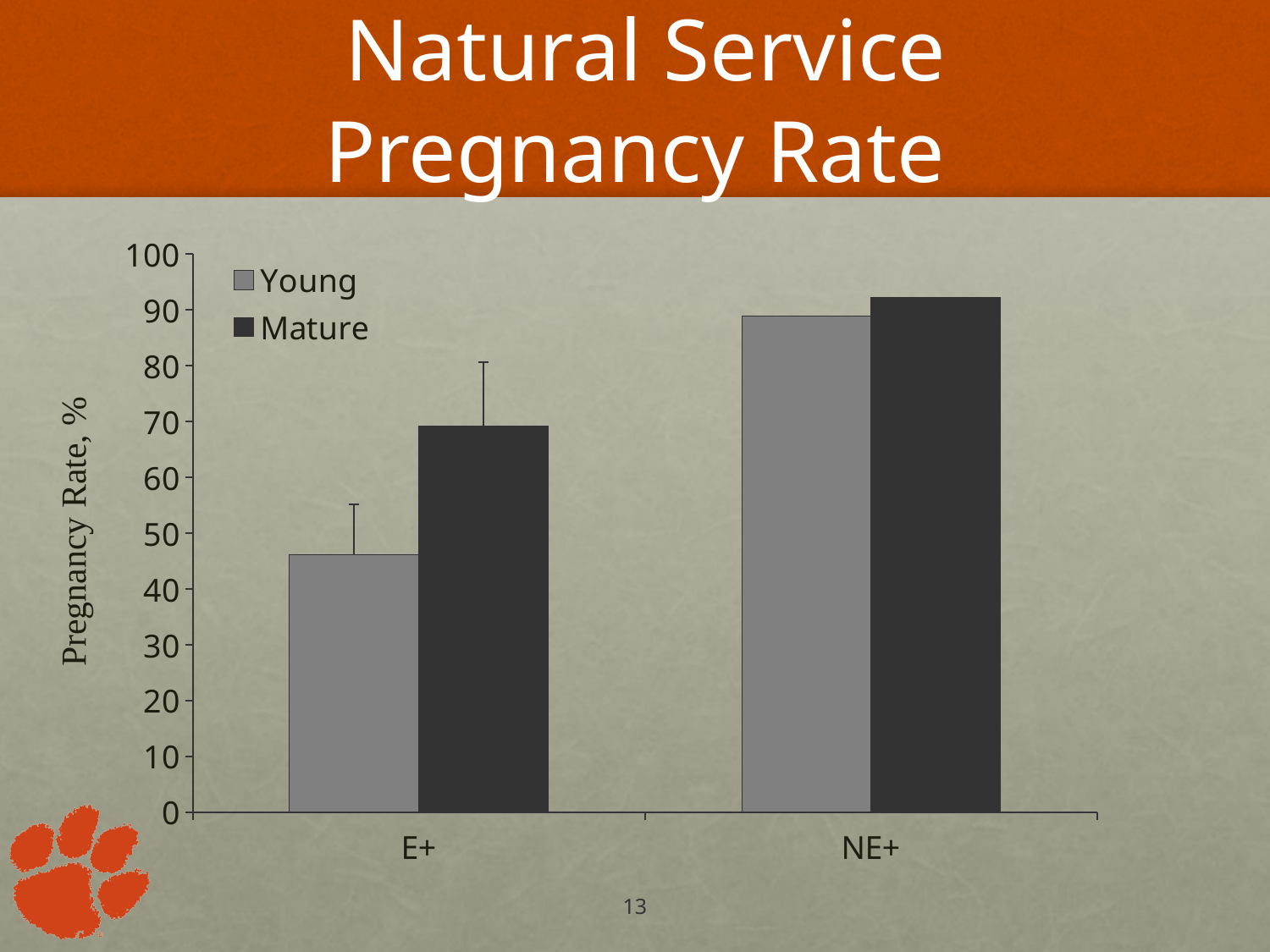
Which bar has the lowest pregnancy rate on the chart? Young, E+ Is the Young pregnancy rate for NE+ greater or less than 80? greater Is the Mature pregnancy rate for NE+ greater or less than 80? greater What is the label of the y axis? Pregnancy Rate, % What are the two series named in the legend? Young and Mature How many series does the legend list? 2 How many categories are shown on the x axis? 2 Is the Young pregnancy rate for E+ greater or less than 50? less What kind of chart is shown on the slide? bar chart Which category has the higher Young pregnancy rate, E+ or NE+? NE+ For E+, which series has the higher pregnancy rate, Young or Mature? Mature